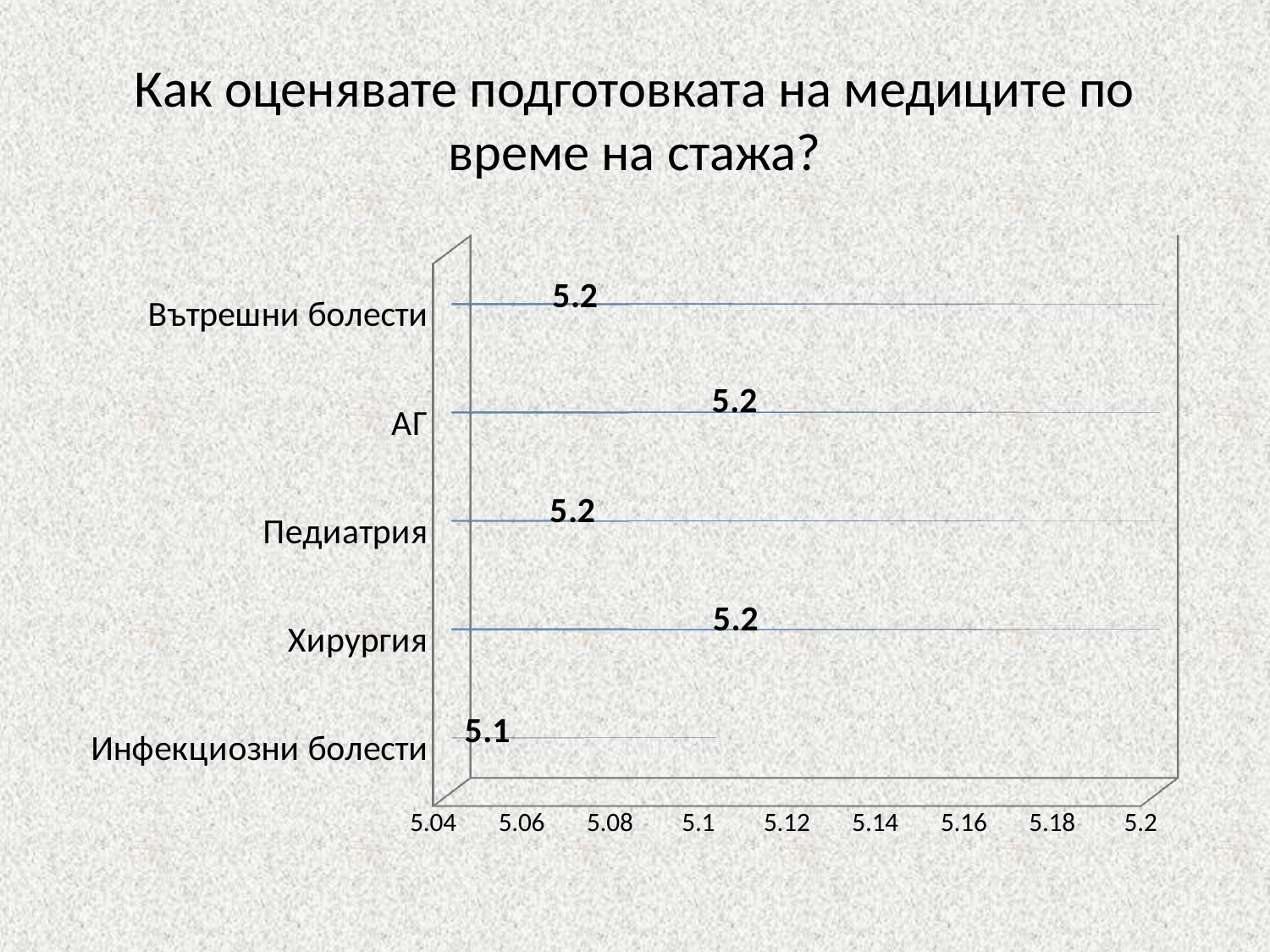
What is the value for Инфекциозни болести? 5.1 Which is larger, the value for Хирургия or the value for Инфекциозни болести? Хирургия Is the value for АГ greater or less than 5.1? greater What kind of chart is shown on the slide? bar chart What is the value for Хирургия? 5.2 What is the title of the slide? Как оценявате подготовката на медиците по време на стажа? What is the difference between the values for Педиатрия and Инфекциозни болести? 0.1 Is the value for Инфекциозни болести greater or less than 5.2? less How many categories are shown in the chart? 5 Which category has the lowest value? Инфекциозни болести What is the value for АГ? 5.2 What is the value for Вътрешни болести? 5.2